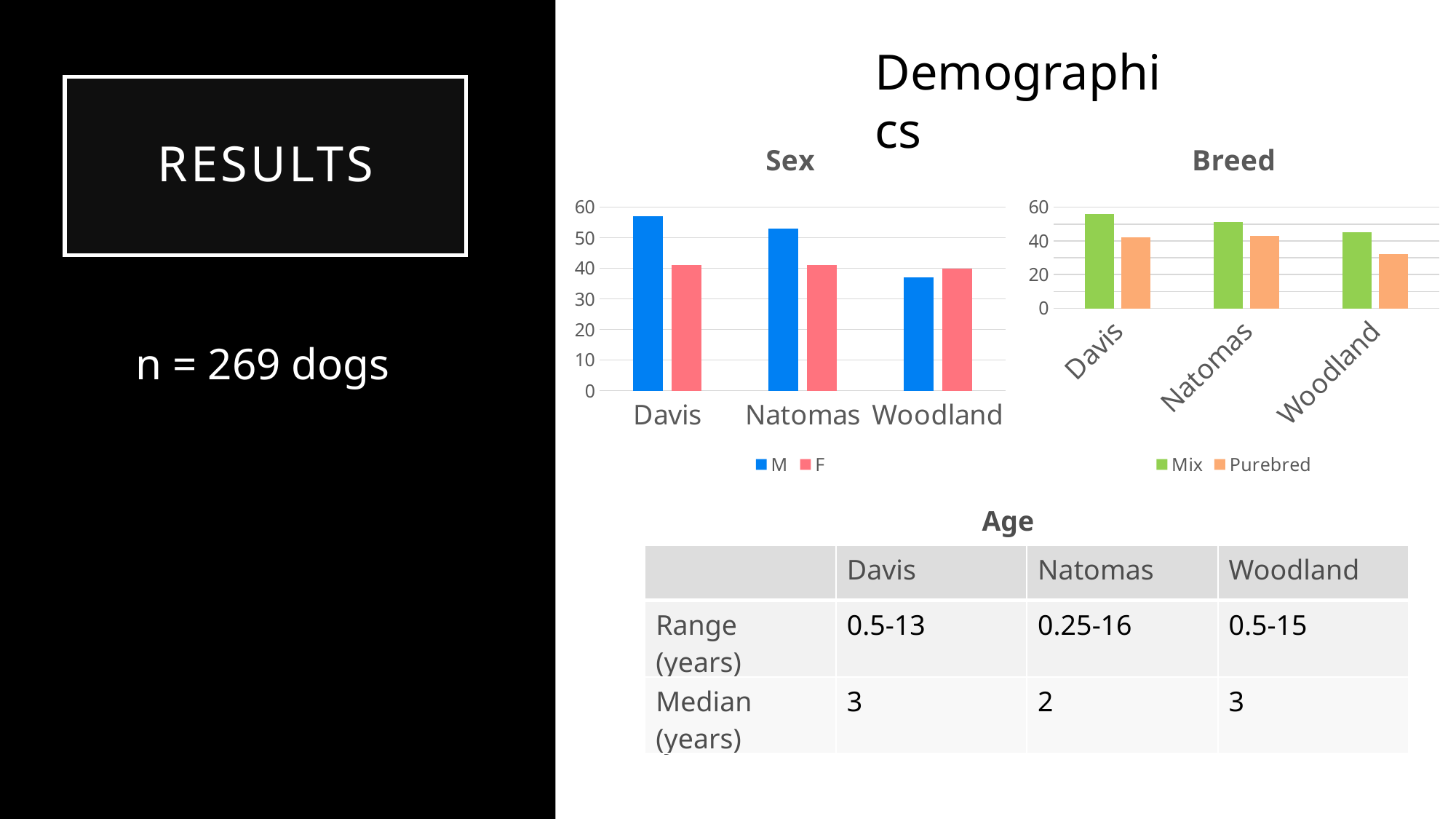
What are the two legend entries of the Sex chart? M and F In the Sex chart, which location has the lowest M value? Woodland In the Breed chart, which location has the lowest Purebred value? Woodland In the Sex chart, which is larger for Natomas, M or F? M How many series does the legend of the Breed chart list? 2 In the Sex chart, is the M value for Davis greater or less than 50? greater What kind of chart is the Sex chart? bar chart In the Sex chart, which location has the highest M value? Davis In the Breed chart, is the Mix value for Davis greater or less than 40? greater In the Breed chart, which is larger for Davis, Mix or Purebred? Mix In the Sex chart, is the F value for Woodland greater or less than 50? less How many categories are shown on the x axis of the Sex chart? 3